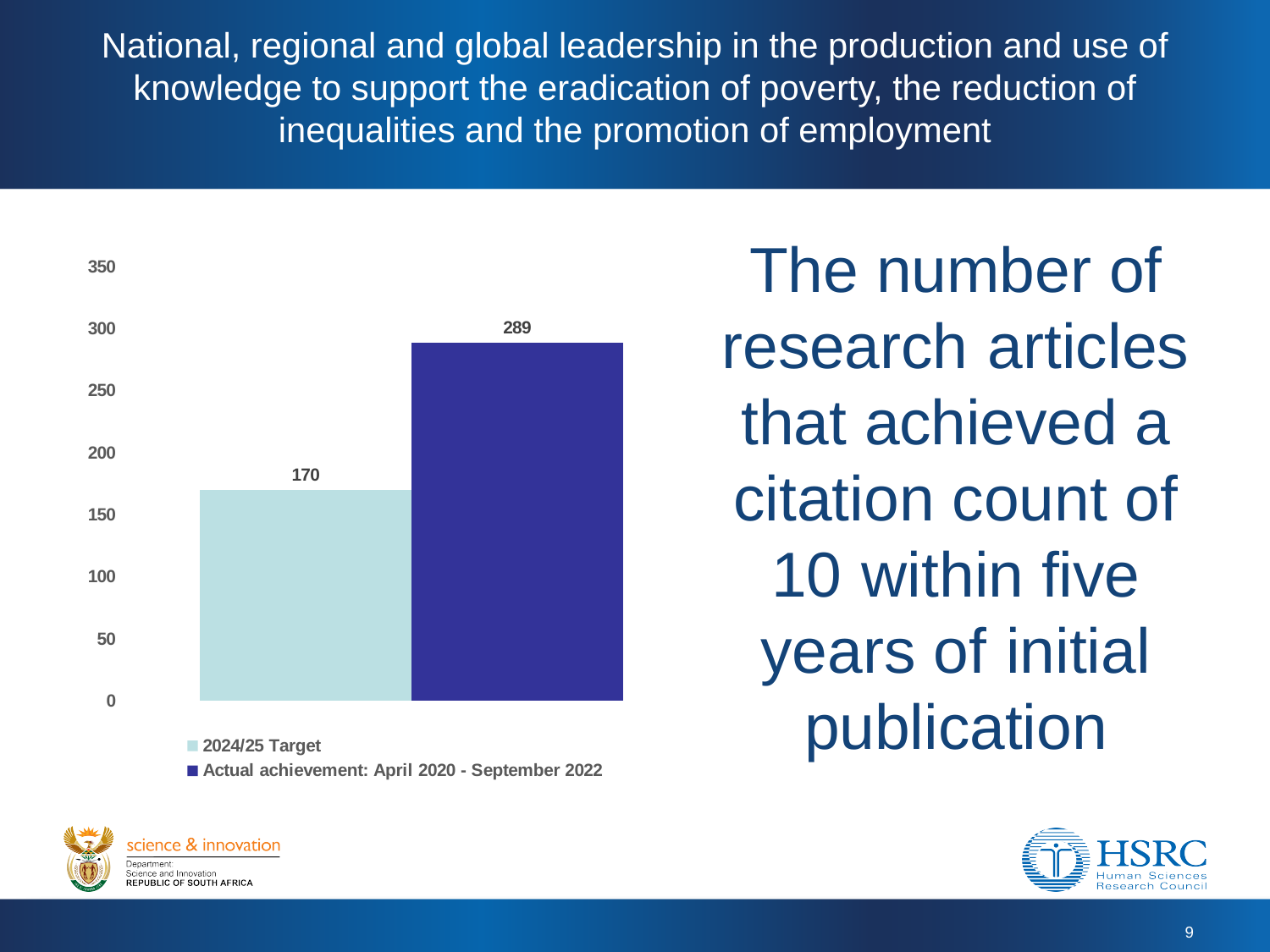
Is the value for the 2024/25 Target greater or less than 200? less Is the Actual achievement value larger or smaller than the 2024/25 Target value? larger By how much does the Actual achievement exceed the 2024/25 Target? 119 Which series has the higher value, the 2024/25 Target or the Actual achievement: April 2020 - September 2022? Actual achievement: April 2020 - September 2022 Is the value for the Actual achievement greater or less than 250? greater What is the value of the Actual achievement: April 2020 - September 2022 bar? 289 What is the maximum value shown on the vertical axis? 350 How many series does the legend list? 2 What is the value of the 2024/25 Target bar? 170 Which series has the lower value? 2024/25 Target What kind of chart is shown on the slide? bar chart How many bars are plotted in the chart? 2